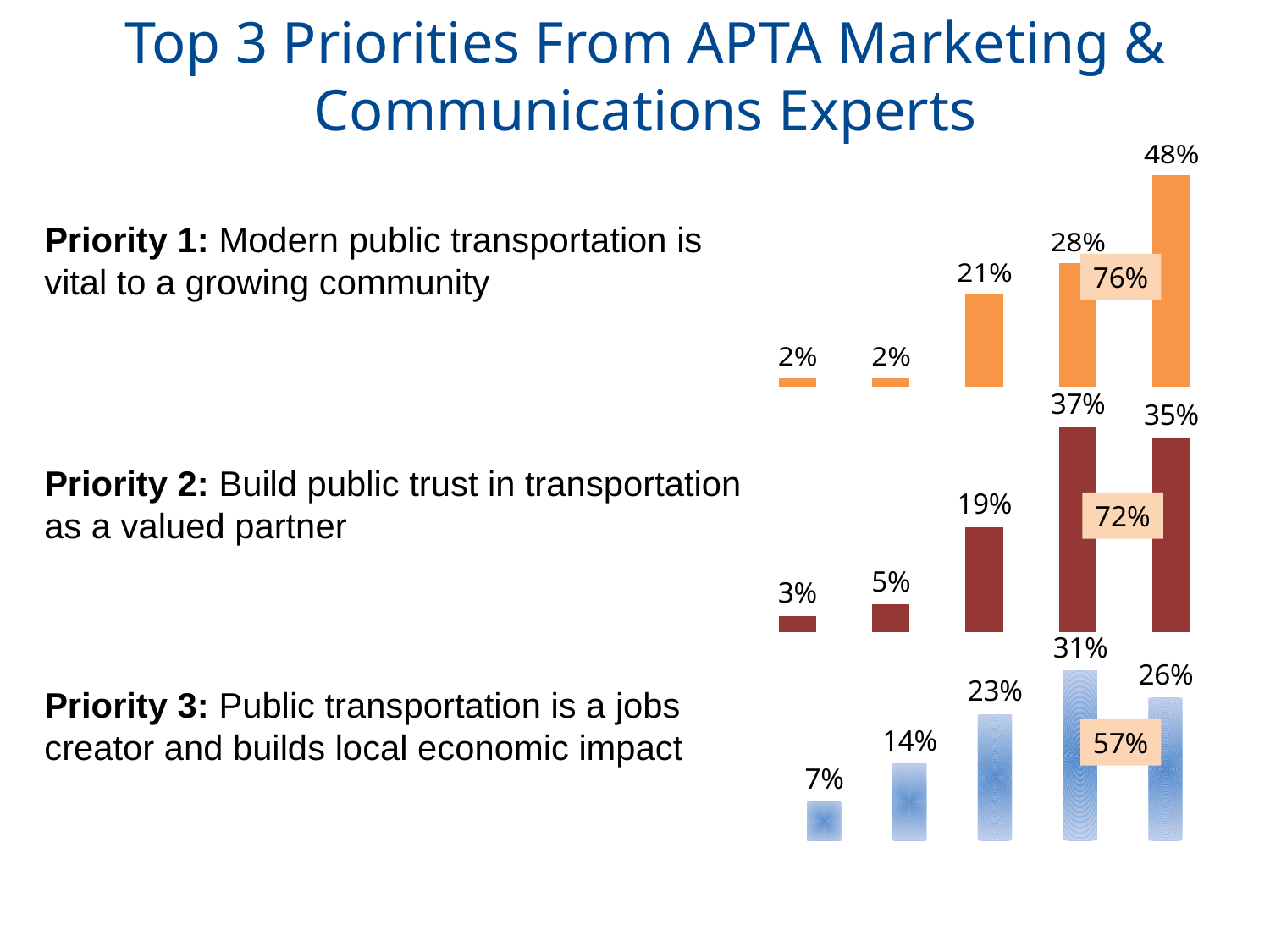
In the Priority 1 chart (orange bars), what is the difference between the fifth bar (48%) and the fourth bar (28%)? 20% In the Priority 3 chart (blue bars), do the values rise or fall from the first bar to the fourth bar? rise In the Priority 2 chart (dark red bars), what is the value of the fourth bar from the left? 37% In the Priority 2 chart (dark red bars), which is larger, the fourth bar or the fifth bar? the fourth bar (37%) In the Priority 3 chart (blue bars), what is the difference between the fourth bar (31%) and the fifth bar (26%)? 5% In the Priority 1 chart (orange bars), what is the value of the tallest bar? 48% In the Priority 3 chart (blue bars), what is the value of the first bar on the left? 7% In the Priority 2 chart (dark red bars), what is the combined value of the fourth and fifth bars, as shown in the highlighted box? 72% How many bars are plotted in the Priority 3 chart (blue bars)? 5 What kind of chart is used for each priority on this slide? bar chart In the Priority 1 chart (orange bars), what is the value of the third bar from the left? 21% What value is shown in the highlighted box overlaid on the Priority 3 chart (blue bars)? 57%